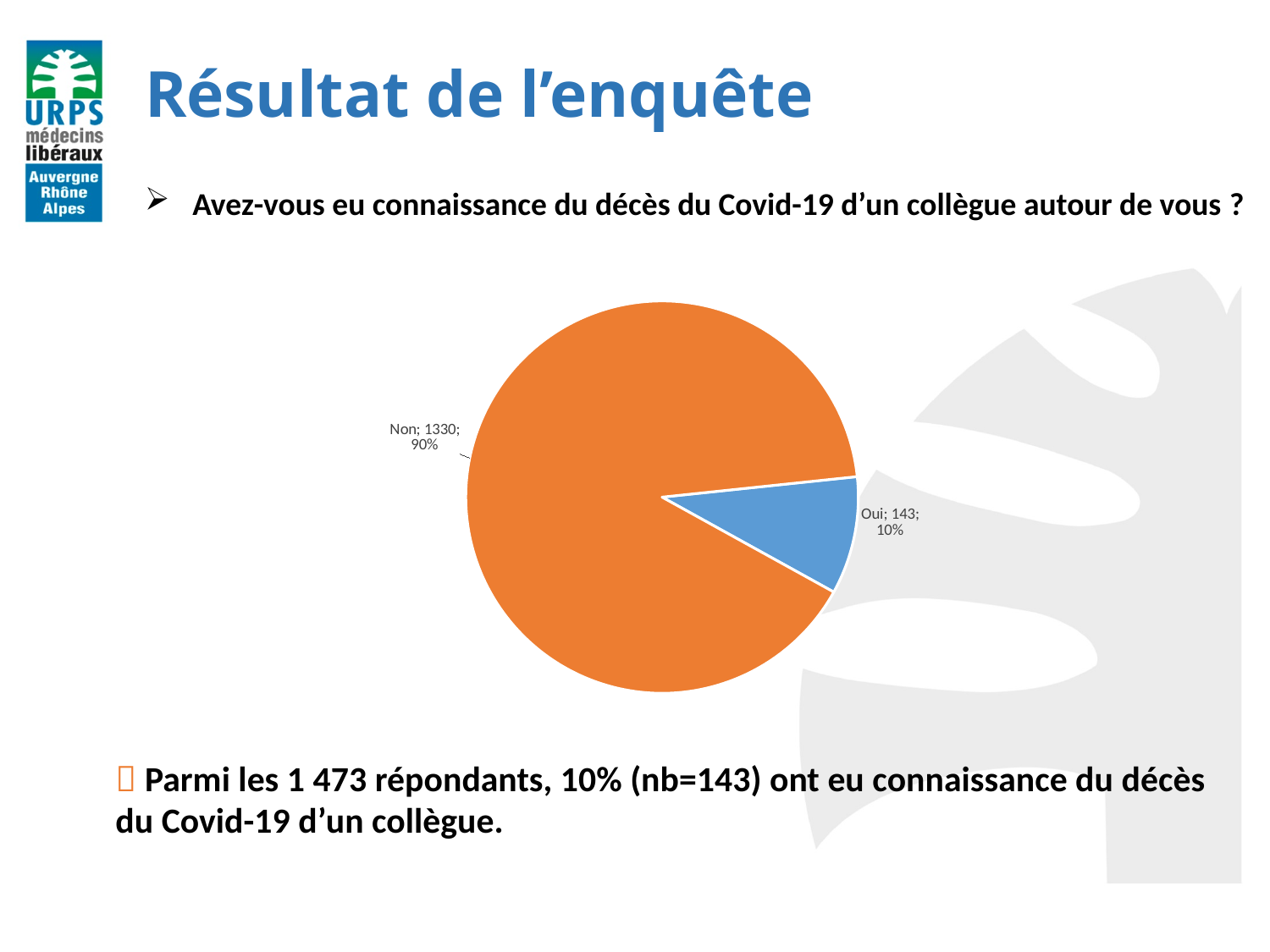
What share of the pie does the Oui slice represent? 10% What is the value for Oui in the pie chart? 143 Which slice is the largest in the pie chart? Non Which slice is the smallest in the pie chart? Oui Which is larger, the value for Oui or the value for Non? Non What kind of chart is shown on the slide? pie chart What is the difference between the Non and Oui values? 1187 How many slices does the pie chart have? 2 What share of the pie does the Non slice represent? 90% What colour is the Oui slice in the pie chart? blue What is the total of the two slices in the pie chart? 1473 What is the value for Non in the pie chart? 1330